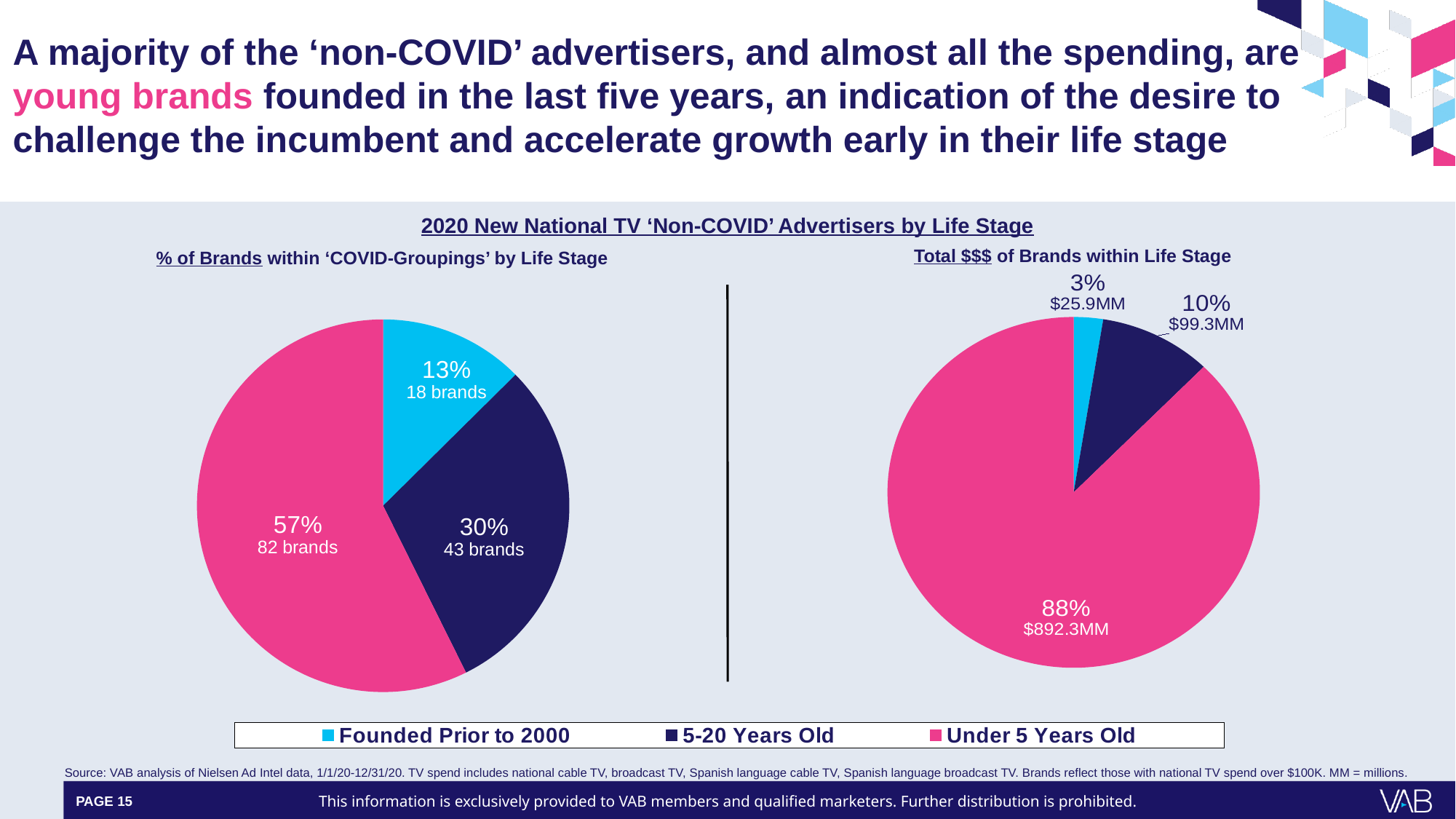
Which colour represents 'Under 5 Years Old' in the pie charts? Pink In the 'Total $$$ of Brands within Life Stage' pie chart, which life stage has the largest share? Under 5 Years Old In the 'Total $$$ of Brands within Life Stage' pie chart, what is the dollar value for brands Founded Prior to 2000? $25.9MM In the 'Total $$$ of Brands within Life Stage' pie chart, what is the dollar value for Under 5 Years Old? $892.3MM In the '% of Brands' pie chart, which life stage has the smallest share? Founded Prior to 2000 How many categories does the legend list for the pie charts? 3 In the '% of Brands' pie chart, what is the difference in number of brands between Under 5 Years Old and 5-20 Years Old? 39 brands In the '% of Brands' pie chart, how many brands are 5-20 Years Old? 43 brands In the '% of Brands' pie chart, what share of brands are Under 5 Years Old? 57% What type of chart is used for '% of Brands within COVID-Groupings by Life Stage'? Pie chart In the 'Total $$$ of Brands within Life Stage' pie chart, what share of spending comes from brands 5-20 Years Old? 10% In the '% of Brands' pie chart, how many brands were Founded Prior to 2000? 18 brands